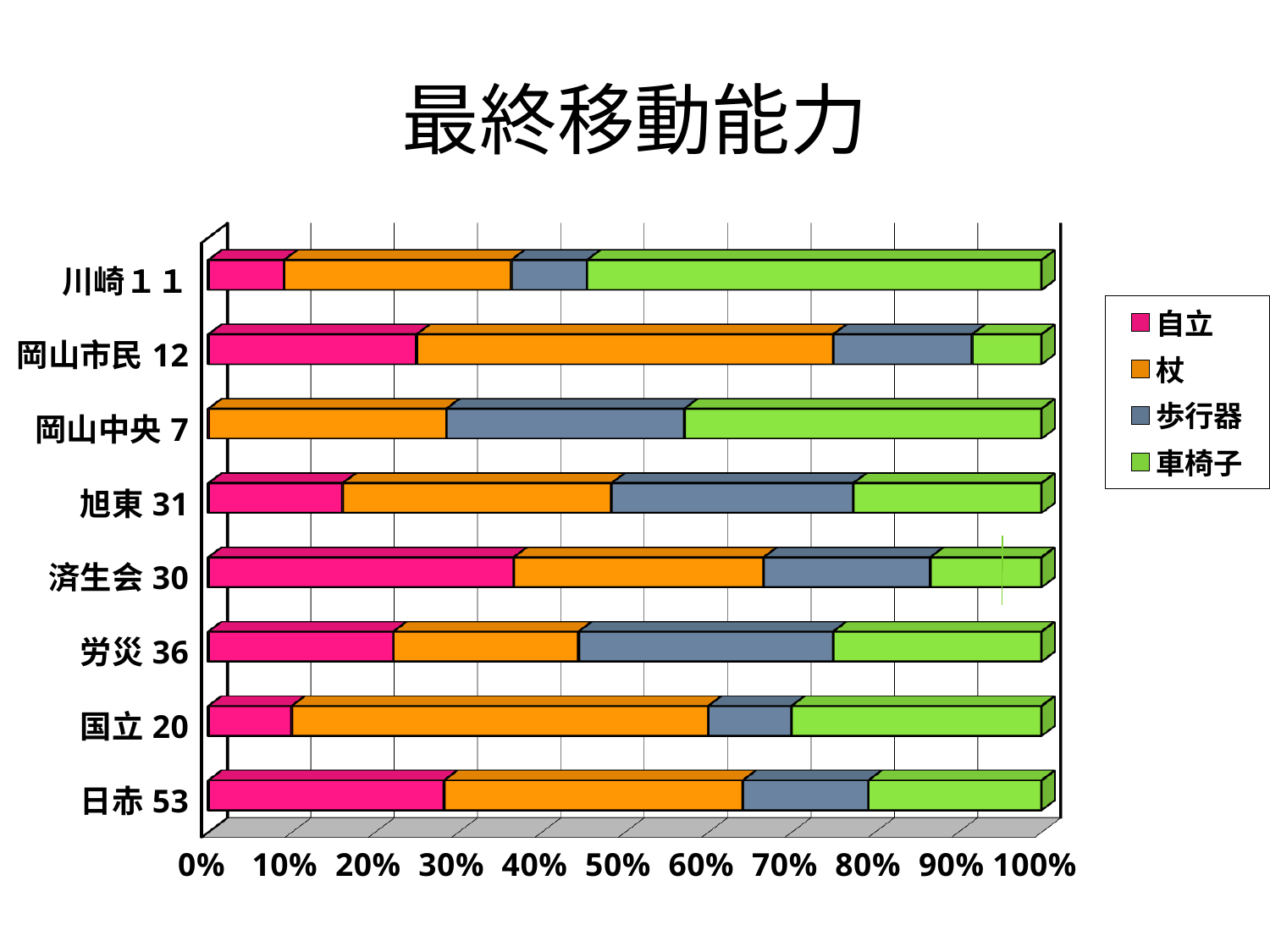
What is the title of the chart? 最終移動能力 Which is larger, the 自立 share for 済生会 30 or for 川崎１１? 済生会 30 Which category has no 自立 segment at all? 岡山中央 7 Which category has the largest 自立 share? 済生会 30 Which legend entry is shown in green? 車椅子 Which category has the largest 車椅子 share? 川崎１１ Is the 車椅子 share for 岡山市民 12 greater or less than 10%? less How many categories (hospitals) are plotted on the chart? 8 Is the 車椅子 share for 川崎１１ greater or less than 50%? greater Which is larger, the 歩行器 share for 岡山中央 7 or for 国立 20? 岡山中央 7 What kind of chart is shown on the slide? Stacked bar chart How many series does the legend list? 4